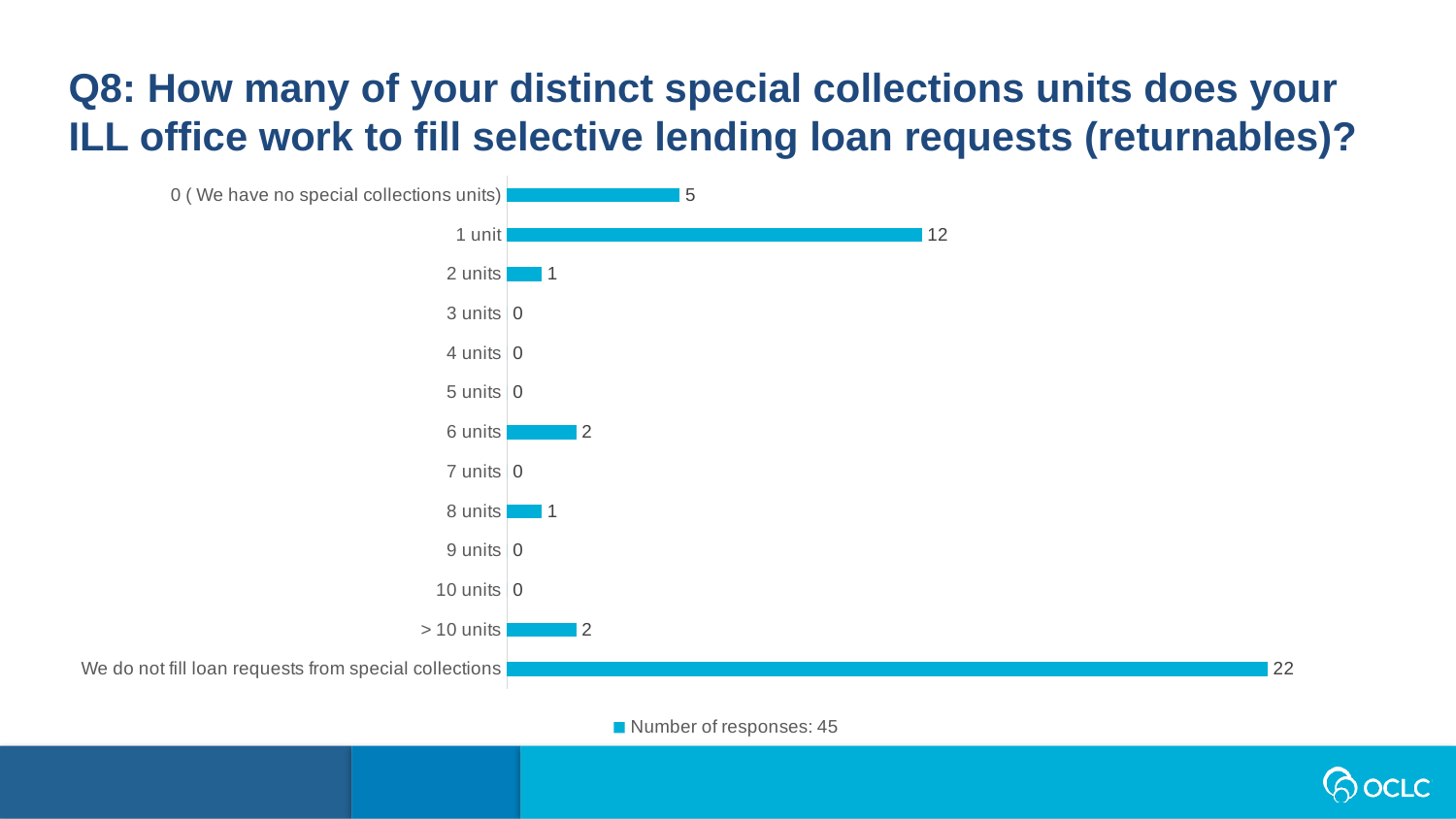
What kind of chart is shown on the slide? Bar chart Which has more responses, '1 unit' or '0 ( We have no special collections units)'? 1 unit How many responses are shown for '1 unit'? 12 What is the total of the values for '2 units', '6 units' and '8 units'? 4 Which category has the highest number of responses? We do not fill loan requests from special collections How many categories are plotted on the chart? 13 How many categories have a value of 0? 7 What is the difference between the values for 'We do not fill loan requests from special collections' and '1 unit'? 10 How many responses are shown for '0 ( We have no special collections units)'? 5 What is the value for '> 10 units'? 2 What does the legend entry say? Number of responses: 45 What is the value for 'We do not fill loan requests from special collections'? 22